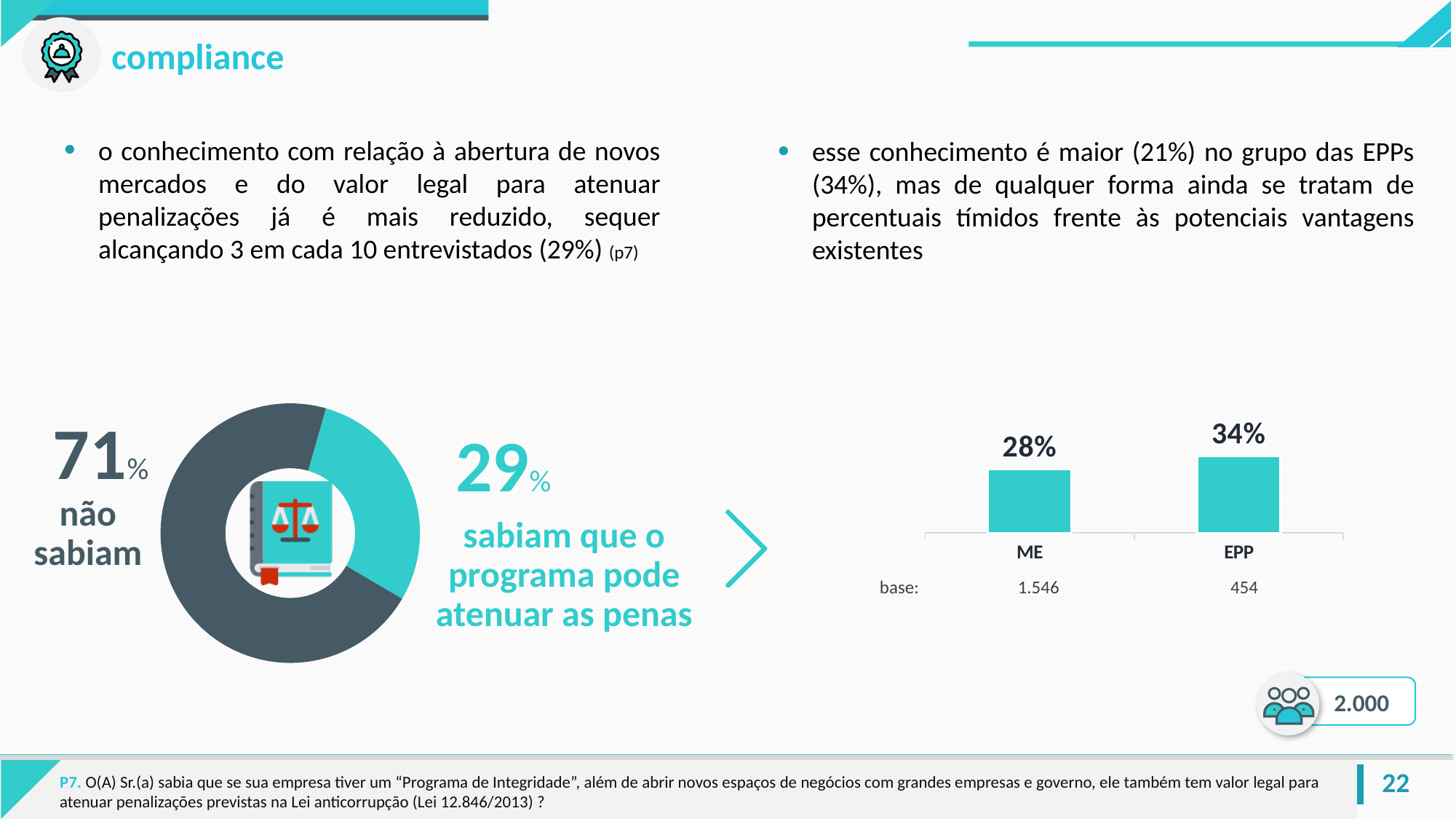
In the bar chart on the right, which category has the higher value, ME or EPP? EPP What kind of chart is shown on the right side of the slide with ME and EPP? Bar chart In the bar chart on the right, what is the difference between the EPP and ME values? 6 percentage points In the bar chart on the right, what is the value for ME? 28% In the donut chart on the left, what share of respondents knew the program can mitigate penalties (sabiam que o programa pode atenuar as penas)? 29% In the donut chart on the left, what share of respondents did not know (não sabiam)? 71% In the bar chart on the right, which category has the lowest value? ME In the bar chart on the right, what is the base (sample size) shown for ME? 1.546 In the donut chart on the left, which segment is larger, 'não sabiam' or 'sabiam que o programa pode atenuar as penas'? não sabiam How many categories are shown in the bar chart on the right? 2 In the bar chart on the right, what is the base (sample size) shown for EPP? 454 In the bar chart on the right, what is the value for EPP? 34%